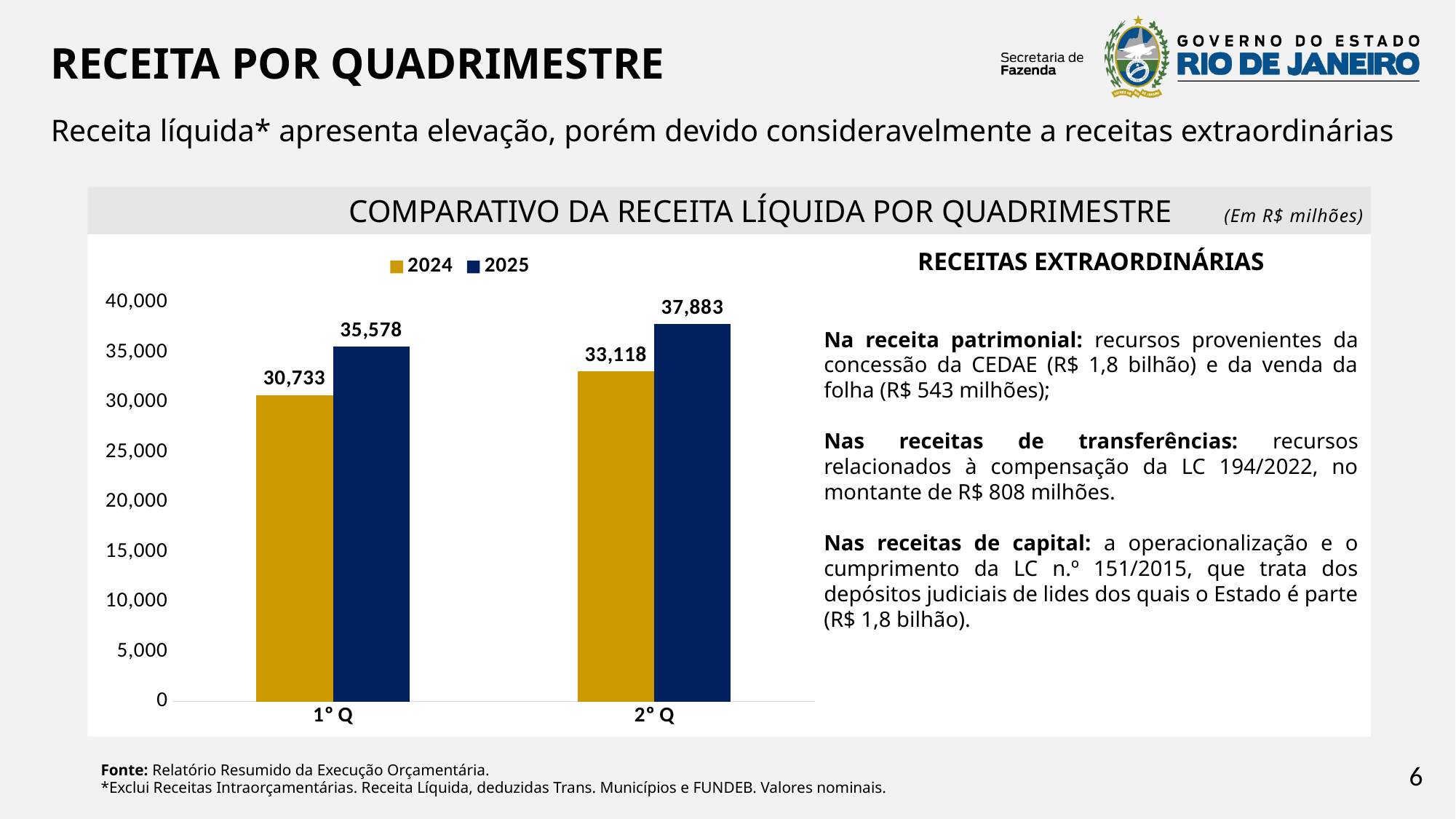
What is the value for 2025 in 2° Q? 37,883 What is the difference between the 2025 and 2024 values in 1° Q? 4,845 What kind of chart is shown on the slide? Bar chart What is the unit stated for the chart values? Em R$ milhões What is the value for 2024 in 1° Q? 30,733 How many series does the legend list? 2 What is the value for 2025 in 1° Q? 35,578 Which bar has the lowest value in the chart? 2024 in 1° Q Which is larger: the 2024 value in 2° Q or the 2025 value in 1° Q? 2025 value in 1° Q What is the difference between the 2025 and 2024 values in 2° Q? 4,765 What is the value for 2024 in 2° Q? 33,118 Which bar has the highest value in the chart? 2025 in 2° Q